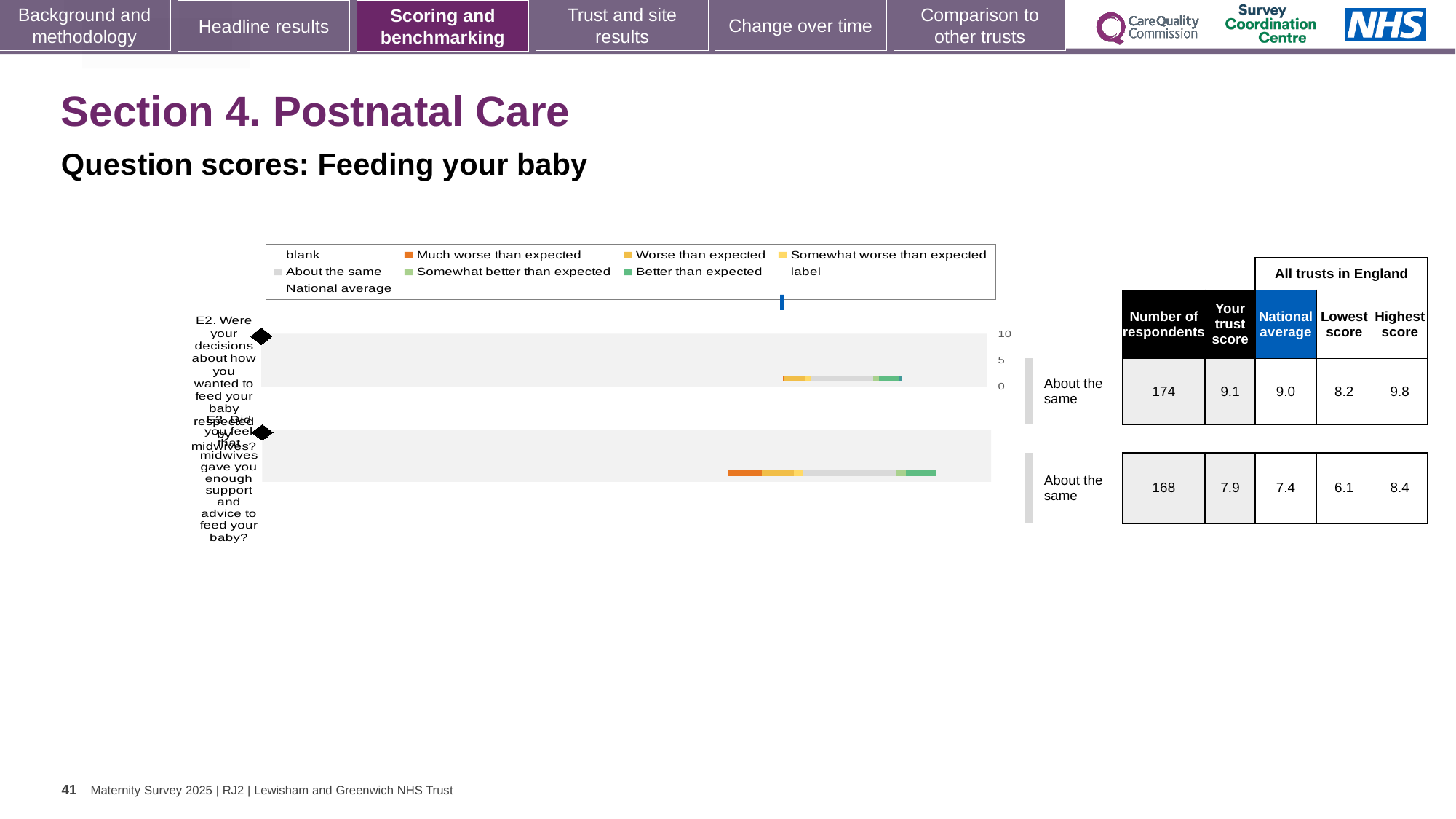
How many respondents answered question E2? 174 What is the lowest score across all trusts in England for question E3? 6.1 How many entries does the chart legend list? 9 What is the subtitle of the chart section on the slide? Question scores: Feeding your baby What is the trust score for question E2 (decisions about how you wanted to feed your baby respected by midwives)? 9.1 What benchmark category is shown next to the bar for question E3? About the same What is the national average for question E3 (midwives gave you enough support and advice to feed your baby)? 7.4 How many questions (categories) are plotted in the chart? 2 Which question has the higher trust score, E2 or E3? E2 What kind of chart is shown on the slide? bar chart By how much does the trust score for E3 exceed the national average for E3? 0.5 What is the difference between the trust scores for E2 and E3? 1.2